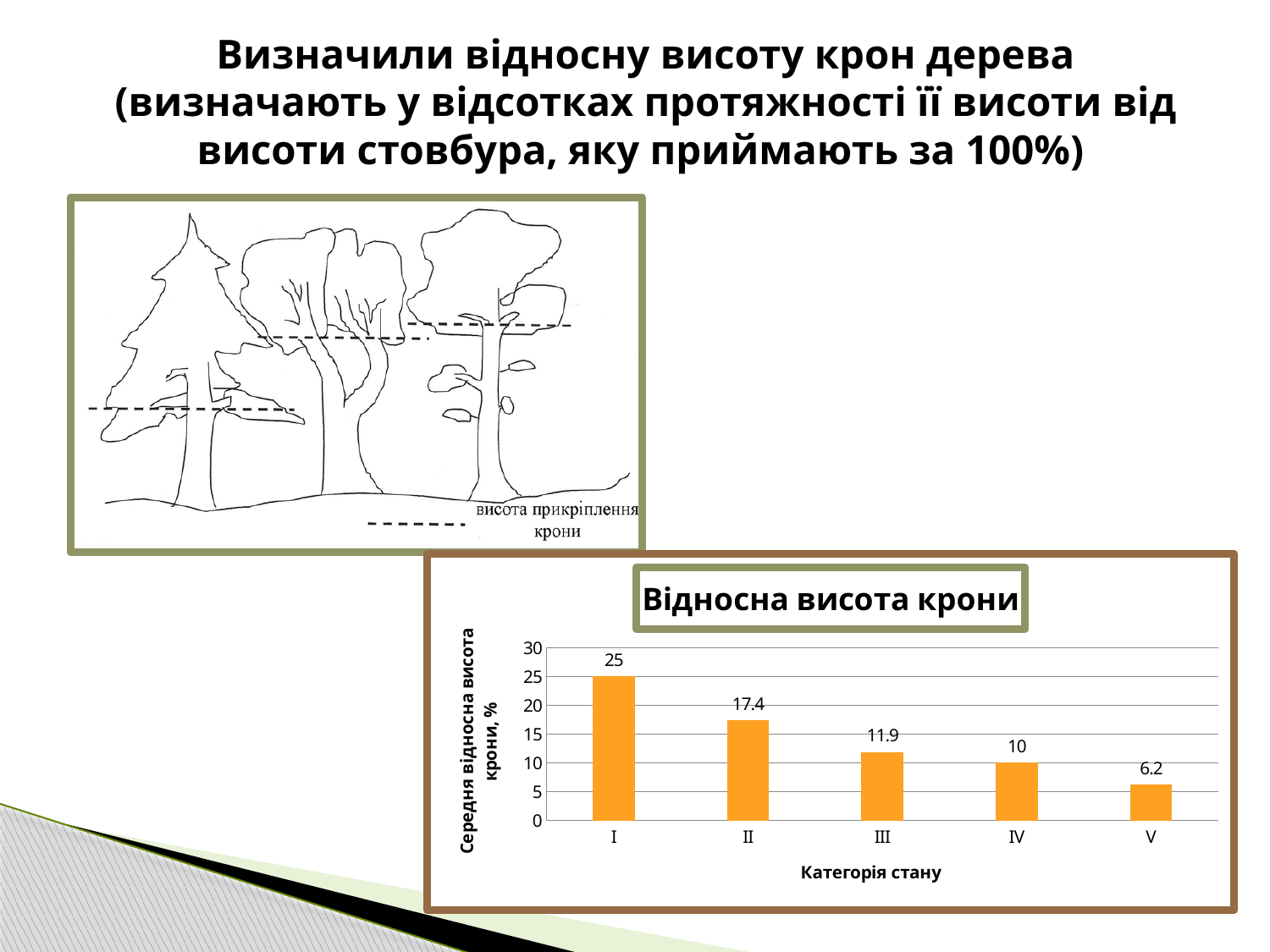
Is the value for category II greater or less than 15? greater What is the value for category III in the chart? 11.9 How many categories are shown on the x axis of the chart? 5 Which category has the lowest value in the chart? V What is the value for category V in the chart? 6.2 What is the difference between the values for category I and category II? 7.6 Which is larger, the value for category II or the value for category IV? II What is the value for category I in the chart? 25 What kind of chart is shown on the slide? bar chart Do the values rise or fall from category I to category V? fall Which category has the highest value in the chart? I What is the difference between the values for category IV and category V? 3.8